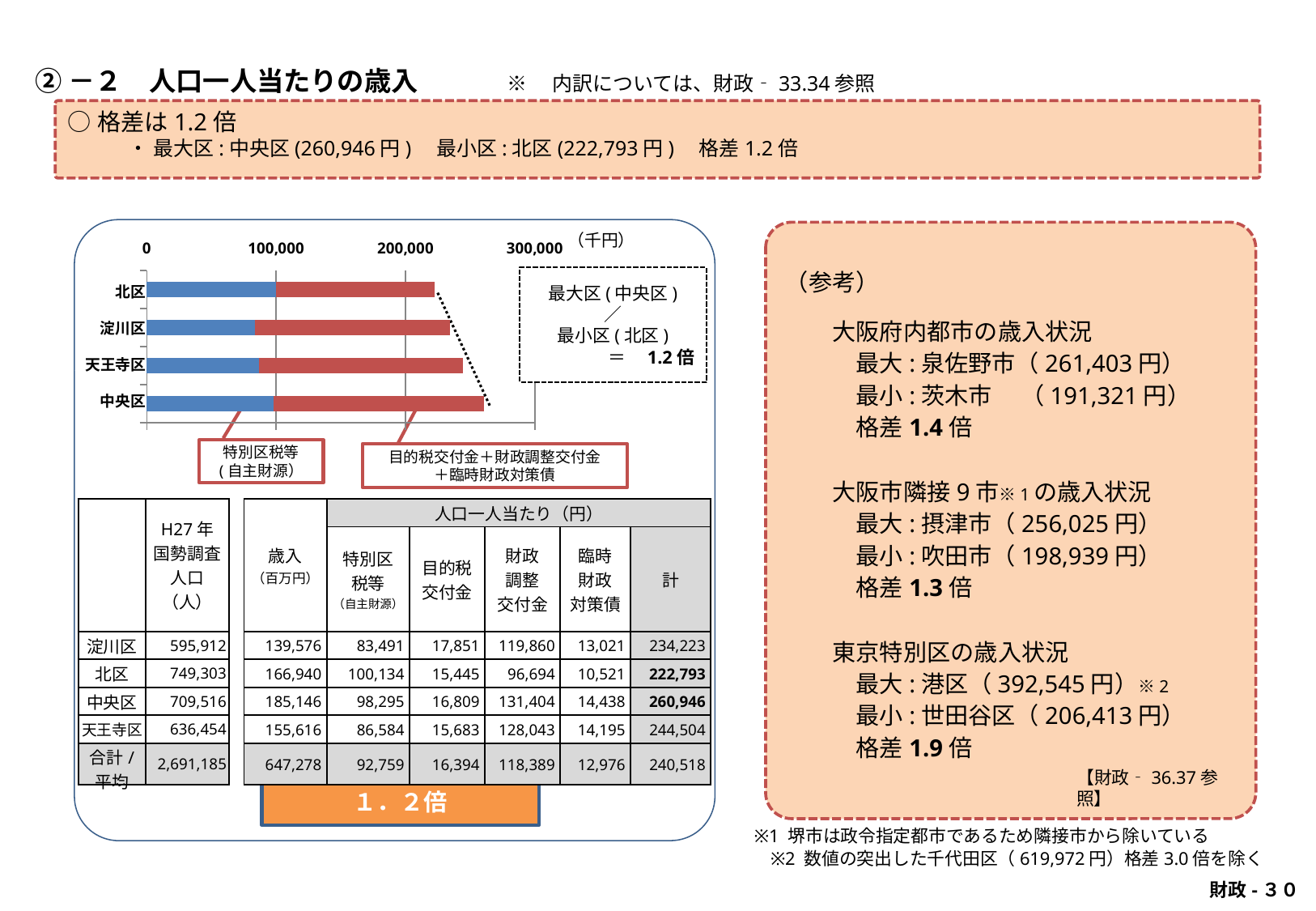
Which ward has the longest total bar in the chart? 中央区 What kind of chart is shown on the slide? stacked bar chart Is the blue (特別区税等) segment for 淀川区 greater or less than 100,000? less Which ward has the larger blue (特別区税等) segment, 北区 or 淀川区? 北区 Which ward has the shortest total bar in the chart? 北区 Which ward has the larger total bar, 中央区 or 北区? 中央区 Is the total bar for 中央区 greater or less than 300,000? less How many series are stacked in each bar of the chart? 2 According to the slide, what is the ratio between the largest ward (中央区) and the smallest ward (北区) shown in the chart? 1.2 倍 What does the blue segment of each bar represent, according to the label below the chart? 特別区税等（自主財源） How many wards (categories) are plotted in the bar chart? 4 Is the total bar for 北区 greater or less than 200,000? greater